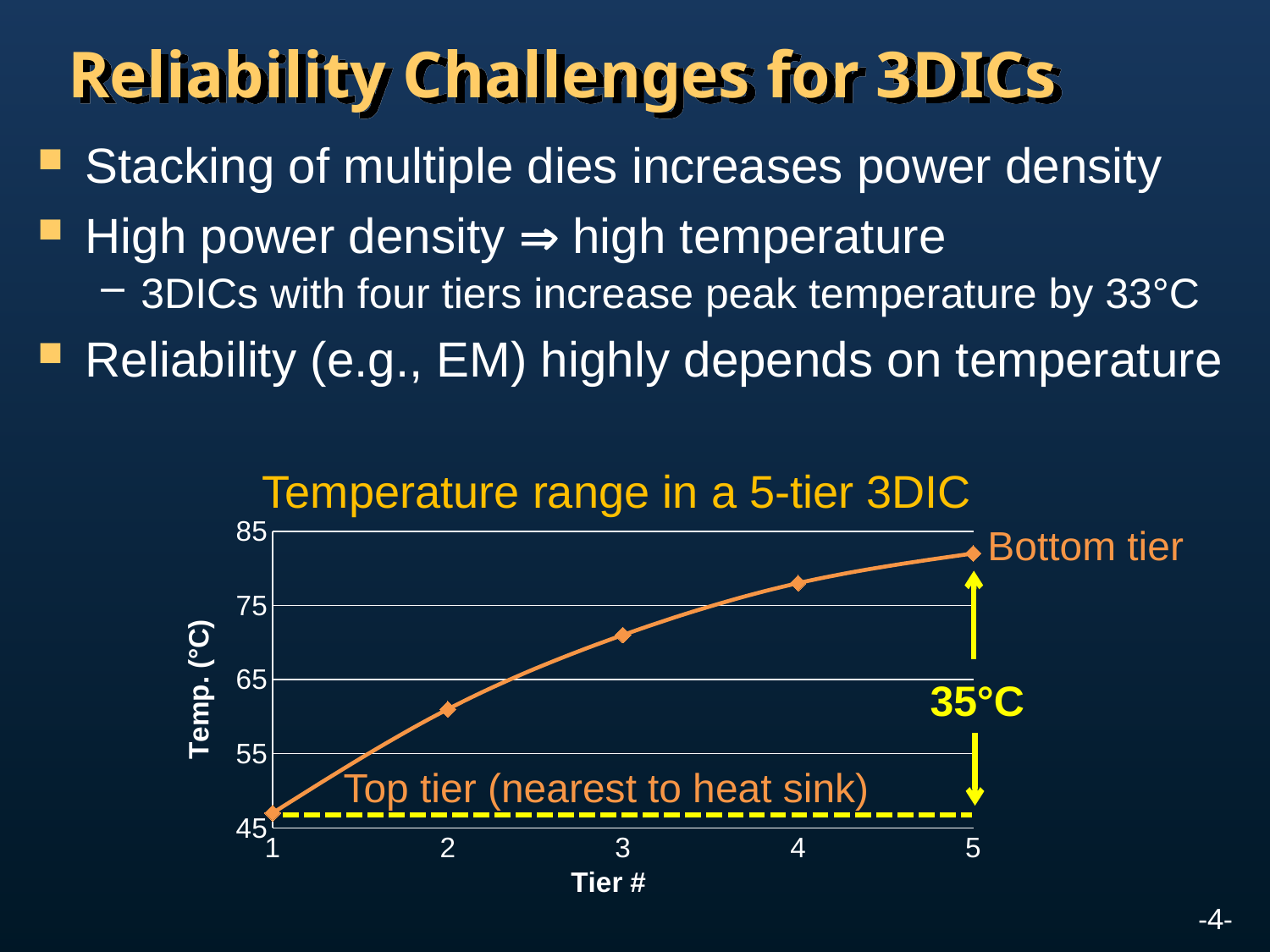
Is the temperature for tier 5 greater or less than 75? greater Is the temperature for tier 1 greater or less than 55? less What is the title of the chart? Temperature range in a 5-tier 3DIC Is the temperature for tier 2 greater or less than 65? less Do the temperature values rise or fall as the tier number increases from 1 to 5? rise What temperature range between the top tier and the bottom tier is annotated on the chart? 35°C Which tier has the highest temperature? 5 What kind of chart is shown on the slide? line chart How many data points are plotted on the line? 5 Which has a higher temperature, tier 2 or tier 4? tier 4 Which tier has the lowest temperature? 1